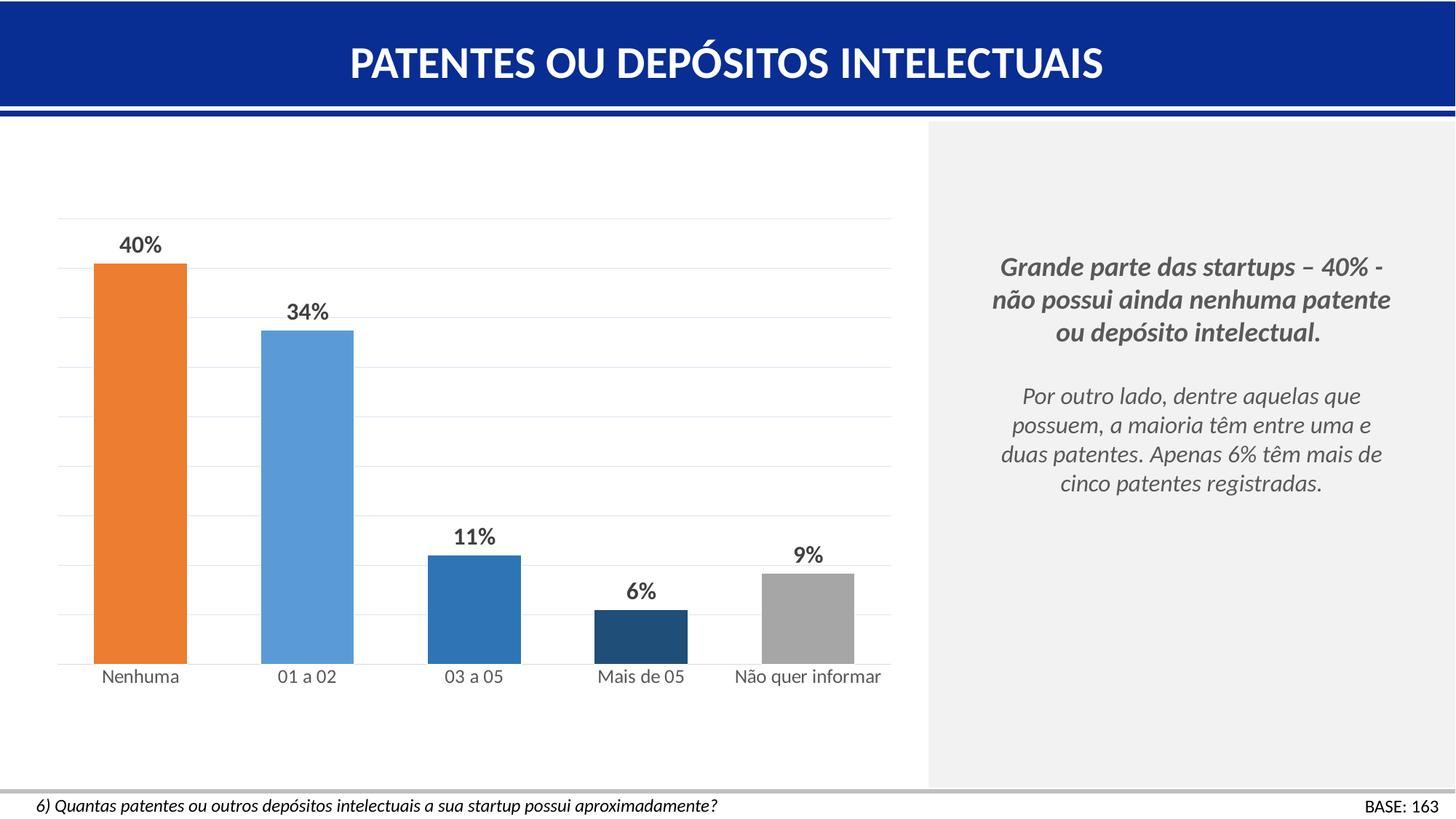
How many categories are shown in the chart? 5 What is the value for "Mais de 05"? 6% What is the value for "01 a 02"? 34% What is the value for "Nenhuma"? 40% What kind of chart is shown on the slide? Bar chart Which category has the lowest value? Mais de 05 Which is larger, the value for "03 a 05" or the value for "Não quer informar"? 03 a 05 What is the difference between the values for "Nenhuma" and "01 a 02"? 6% What colour is the bar for "Nenhuma"? Orange What is the value for "03 a 05"? 11% What is the value for "Não quer informar"? 9% Which category has the highest value? Nenhuma